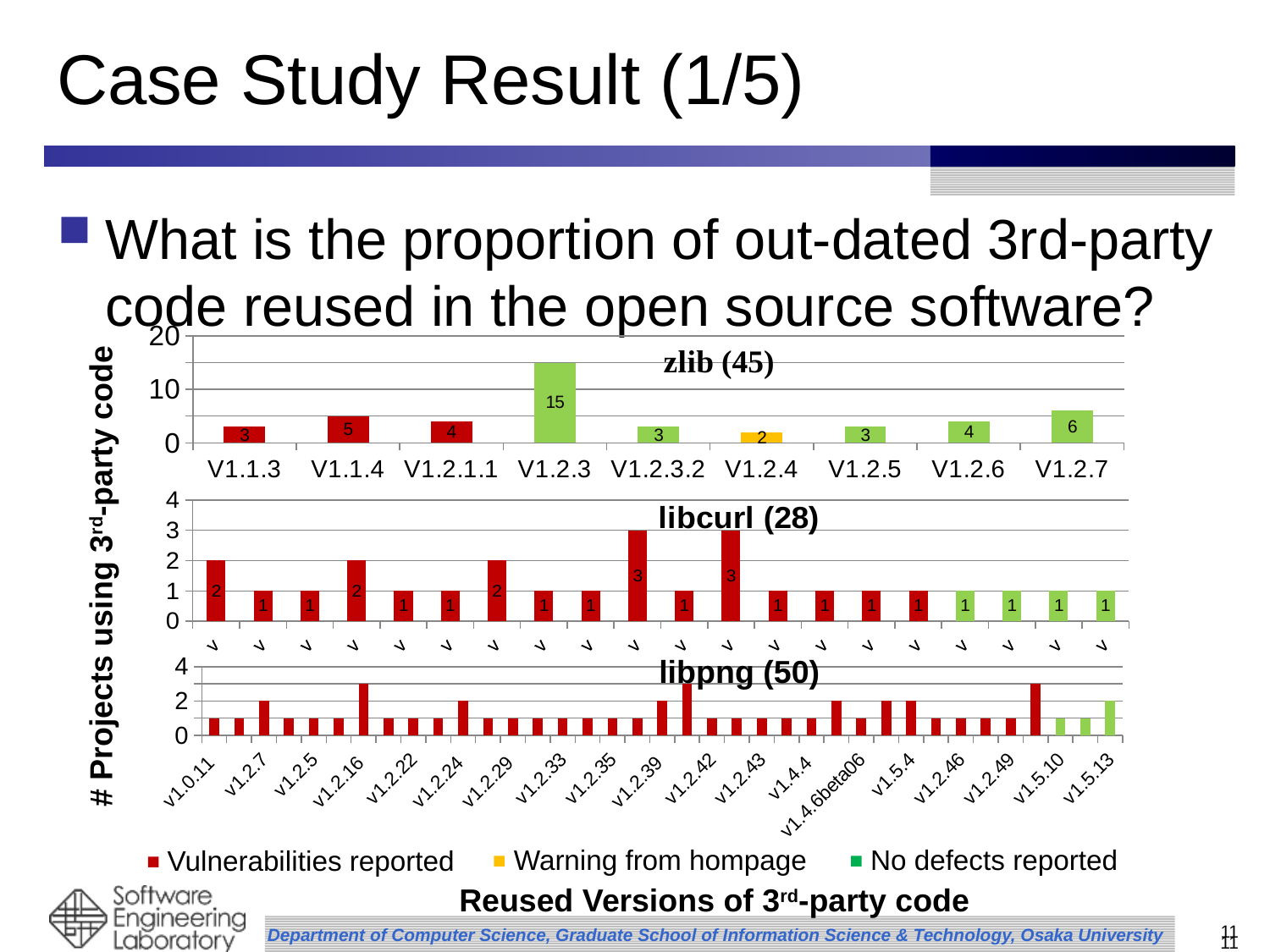
In the libcurl (28) chart, what is the highest value shown on any bar? 3 In the zlib (45) chart, which version has the highest number of projects? V1.2.3 In the zlib (45) chart, what is the value for V1.2.7? 6 In the zlib (45) chart, which version has the lowest number of projects? V1.2.4 In the zlib (45) chart, what is the difference between the values for V1.2.3 and V1.1.4? 10 In the zlib (45) chart, which is larger, the value for V1.1.4 or the value for V1.2.6? V1.1.4 What type of chart is the libpng (50) chart? bar chart In the zlib (45) chart, how many versions are shown on the x axis? 9 How many series does the legend at the bottom of the slide list? 3 In the zlib (45) chart, is the value for V1.2.3 greater or less than 10? greater In the libcurl (28) chart, how many bars are plotted? 20 In the zlib (45) chart, what is the value for V1.2.3? 15